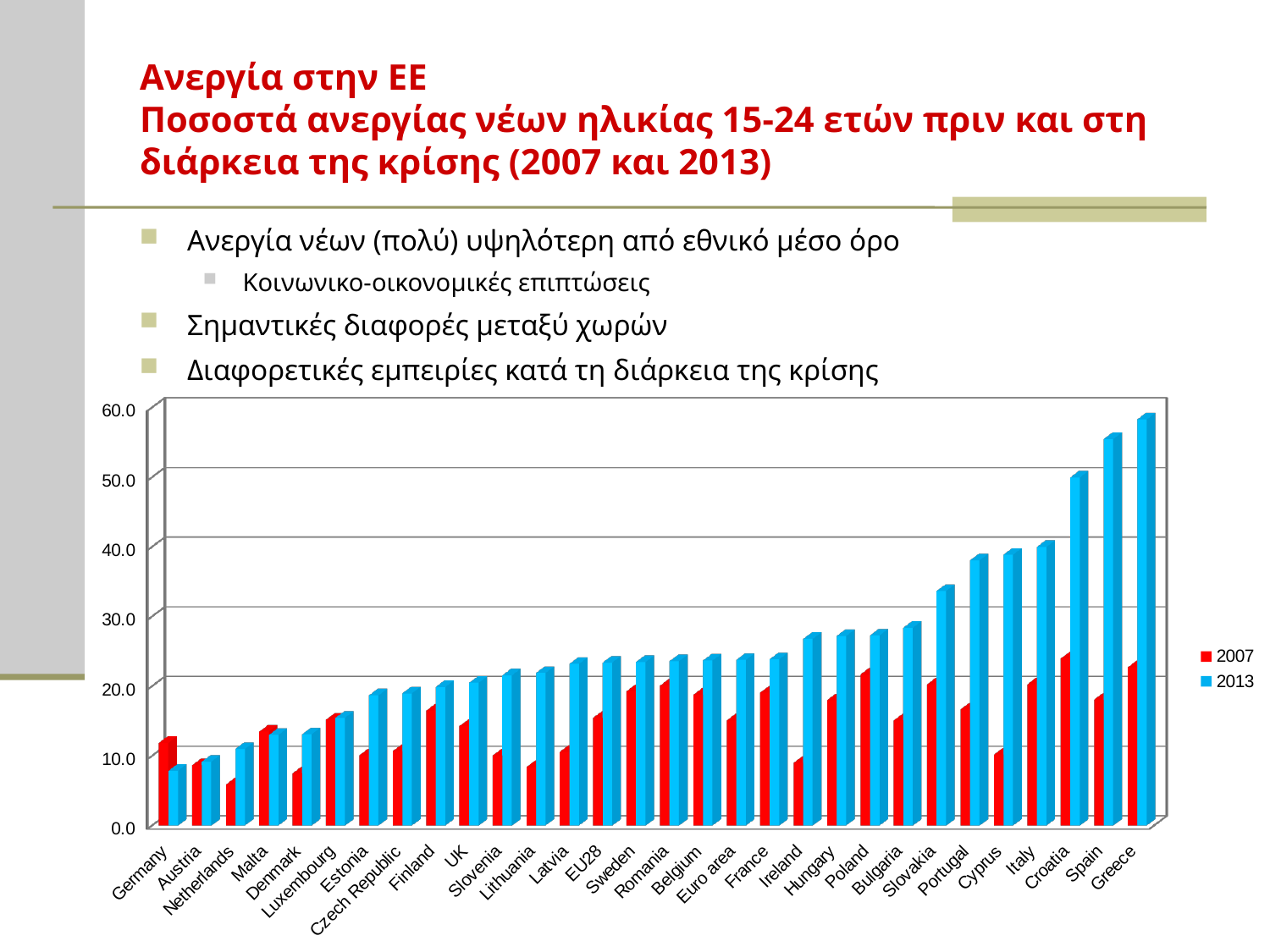
How many countries/regions are shown on the x axis? 30 Is the 2013 value for Greece greater or less than 50? greater Which category has the highest value for 2013? Greece Do the 2013 values generally rise or fall moving from left to right along the x axis? rise What kind of chart is shown on the slide? bar chart For Germany, which is larger: the 2007 value or the 2013 value? 2007 How many series does the legend list? 2 Is the 2013 value for Slovakia greater or less than 30? greater Is the 2013 value for Germany greater or less than 10? less Which years are listed in the legend? 2007 and 2013 Which category has the lowest value for 2013? Germany